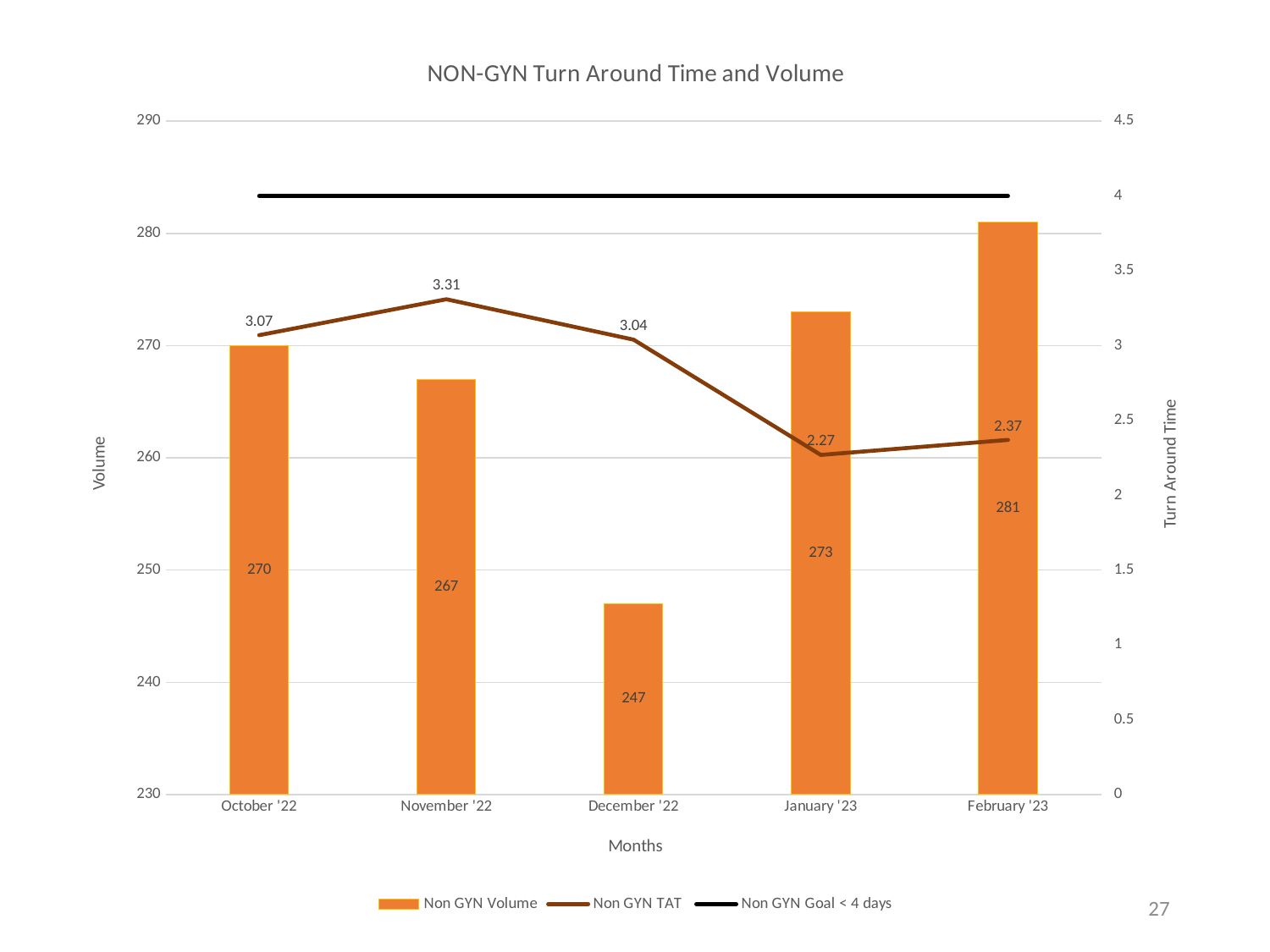
What is the Non GYN TAT for November '22? 3.31 How many months are shown on the x axis? 5 What is the title of the chart? NON-GYN Turn Around Time and Volume Does the Non GYN TAT rise or fall from November '22 to January '23? fall What is the Non GYN TAT for January '23? 2.27 Which month has the highest Non GYN Volume? February '23 What is the difference in Non GYN Volume between February '23 and December '22? 34 Is the Non GYN TAT for February '23 greater or less than 4? less What is the Non GYN Volume for December '22? 247 Which is larger, the Non GYN Volume for October '22 or November '22? October '22 How many series does the legend list? 3 Which month has the lowest Non GYN TAT? January '23